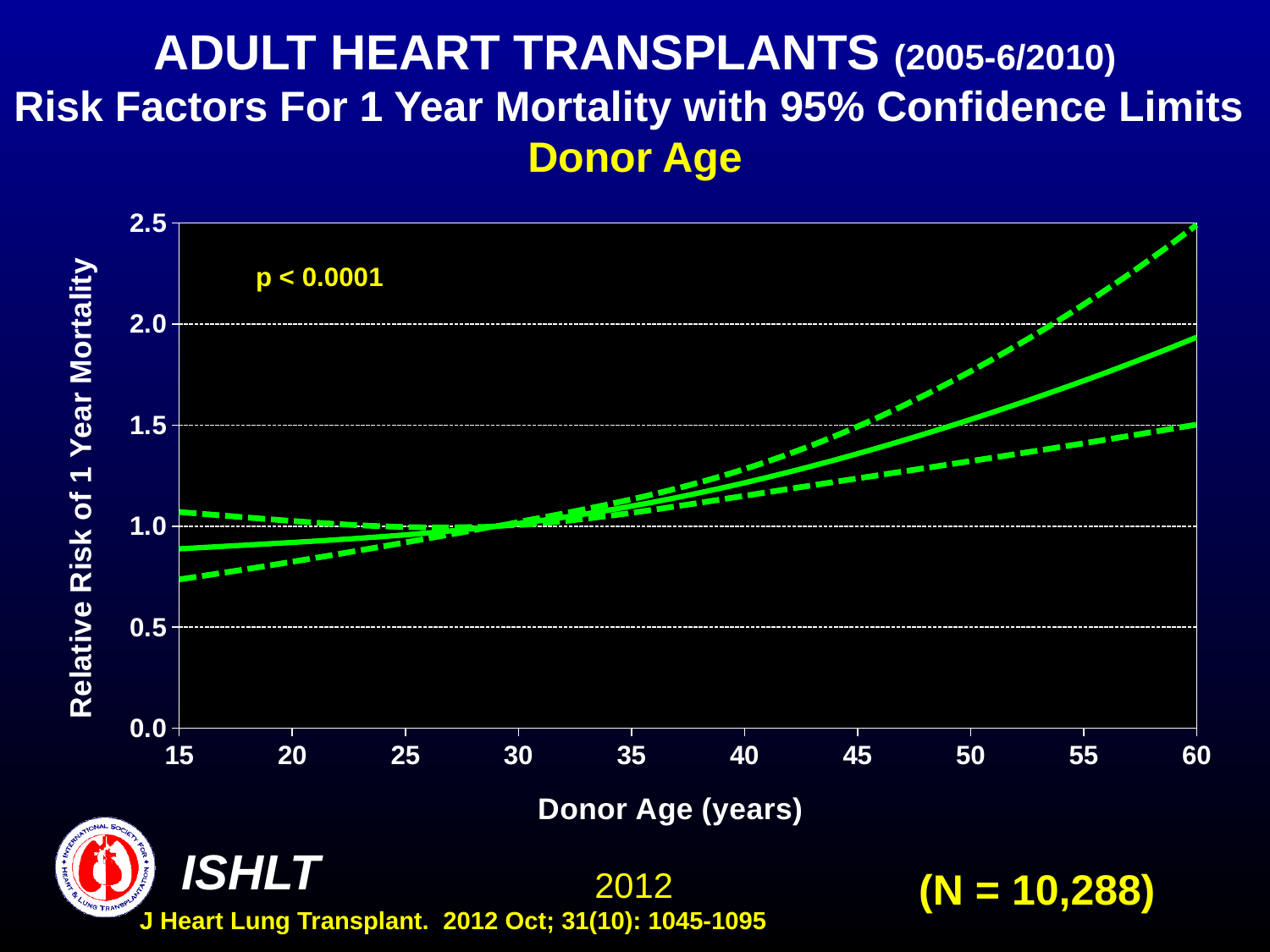
Is the relative risk (solid line) at donor age 40 greater or less than 1.5? less Does the relative risk of 1 year mortality rise or fall as donor age increases from 30 to 60 years? rise What p-value is shown on the chart? p < 0.0001 What is the label of the x axis? Donor Age (years) Is the upper 95% confidence limit (upper dashed line) at donor age 50 greater or less than 1.5? greater What kind of chart is shown on the slide? line chart How many lines are plotted on the chart? 3 Is the relative risk (solid line) at donor age 60 greater or less than 1.5? greater